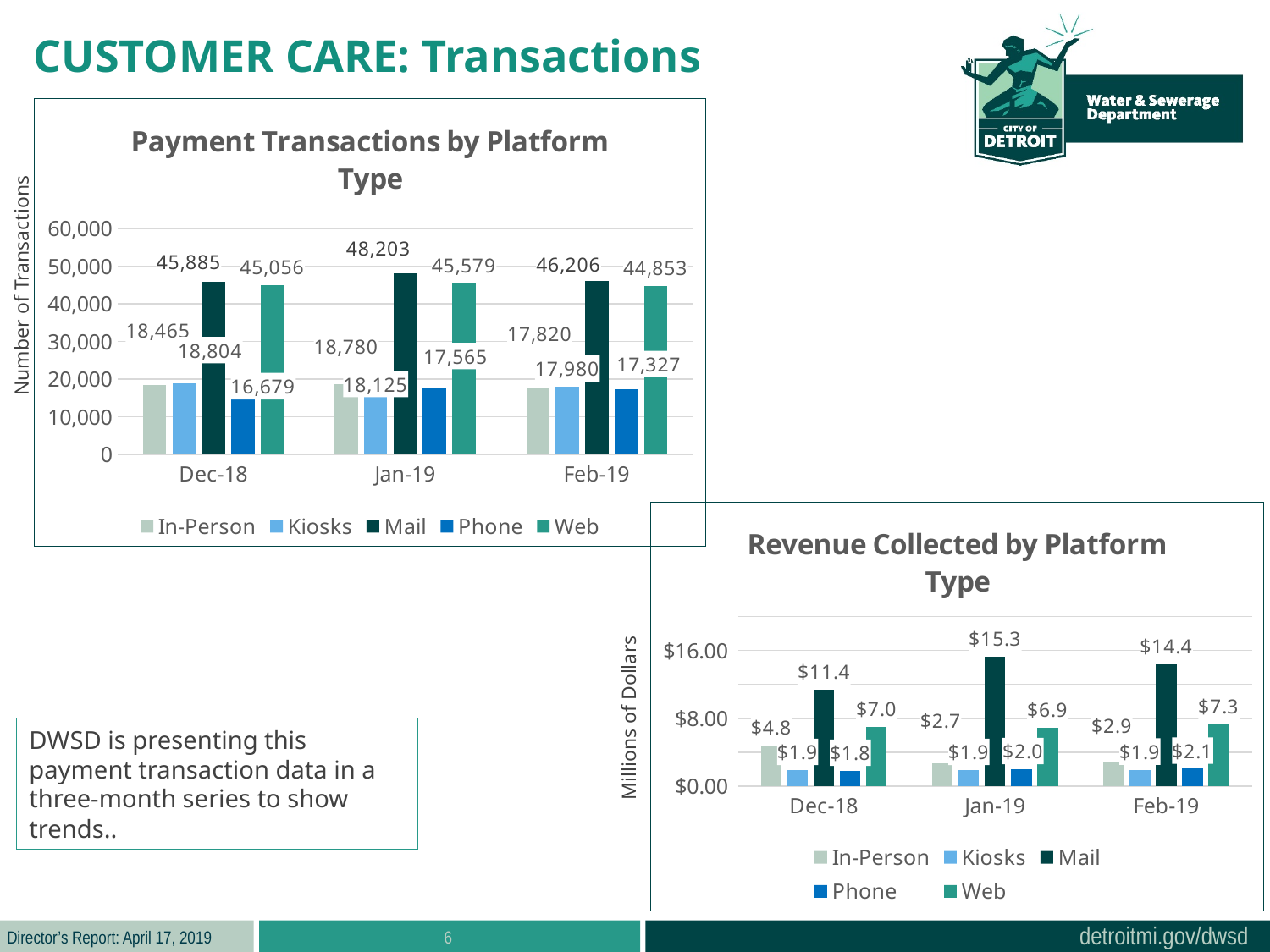
In the Payment Transactions by Platform Type chart, which platform had the highest number of transactions in Feb-19? Mail In the Revenue Collected by Platform Type chart, which platform collected the least revenue in Dec-18? Phone In the Revenue Collected by Platform Type chart, how many months are shown on the x axis? 3 In the Revenue Collected by Platform Type chart, how much revenue was collected by Mail in Jan-19? $15.3 In the Revenue Collected by Platform Type chart, is the Web value for Feb-19 larger than the In-Person value for Feb-19? Yes In the Payment Transactions by Platform Type chart, what is the value for Phone in Dec-18? 16,679 In the Revenue Collected by Platform Type chart, what is the In-Person value for Dec-18? $4.8 In the Payment Transactions by Platform Type chart, do Web transactions rise or fall from Jan-19 to Feb-19? fall In the Payment Transactions by Platform Type chart, what is the difference between Mail and Web transactions in Jan-19? 2,624 In the Payment Transactions by Platform Type chart, how many transactions were made by Mail in Jan-19? 48,203 In the Payment Transactions by Platform Type chart, how many series does the legend list? 5 What type of chart is the Revenue Collected by Platform Type chart? Bar chart